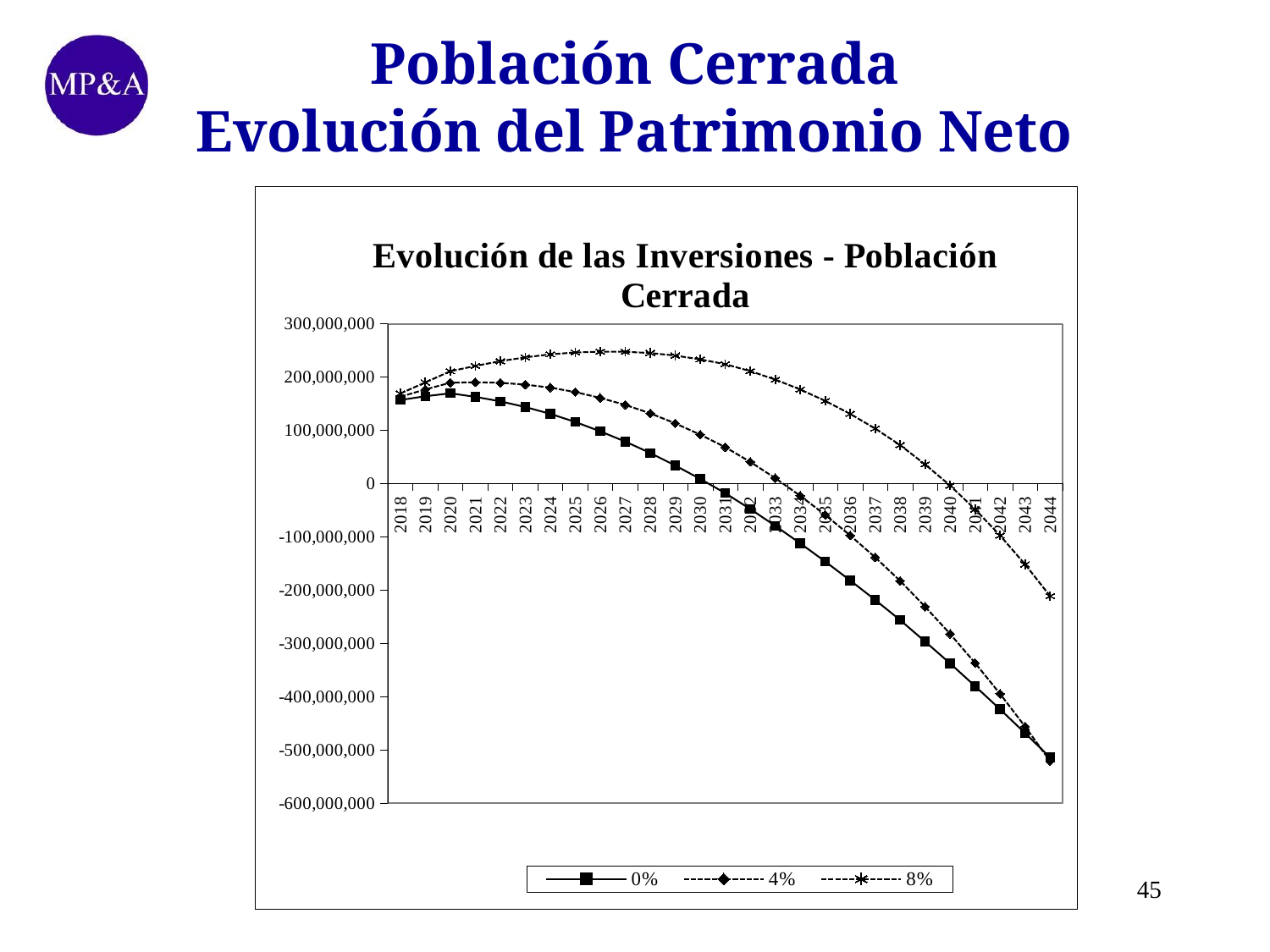
How many series does the legend list? 3 How many years are plotted along the x axis? 27 Is the value for the 0% series in 2044 greater or less than -500,000,000? less Which series has the lowest value in 2044? 4% Is the value for the 8% series in 2026 greater or less than 200,000,000? greater Does the 0% series rise or fall from 2020 to 2044? fall What kind of chart is shown on the slide? line chart Which series is drawn with a solid line and square markers? 0% Which series has the highest value in 2035? 8% What is the title of the chart? Evolución de las Inversiones - Población Cerrada Is the value for the 4% series in 2040 greater or less than -200,000,000? less In 2044, which is larger: the value for the 8% series or the value for the 0% series? 8%